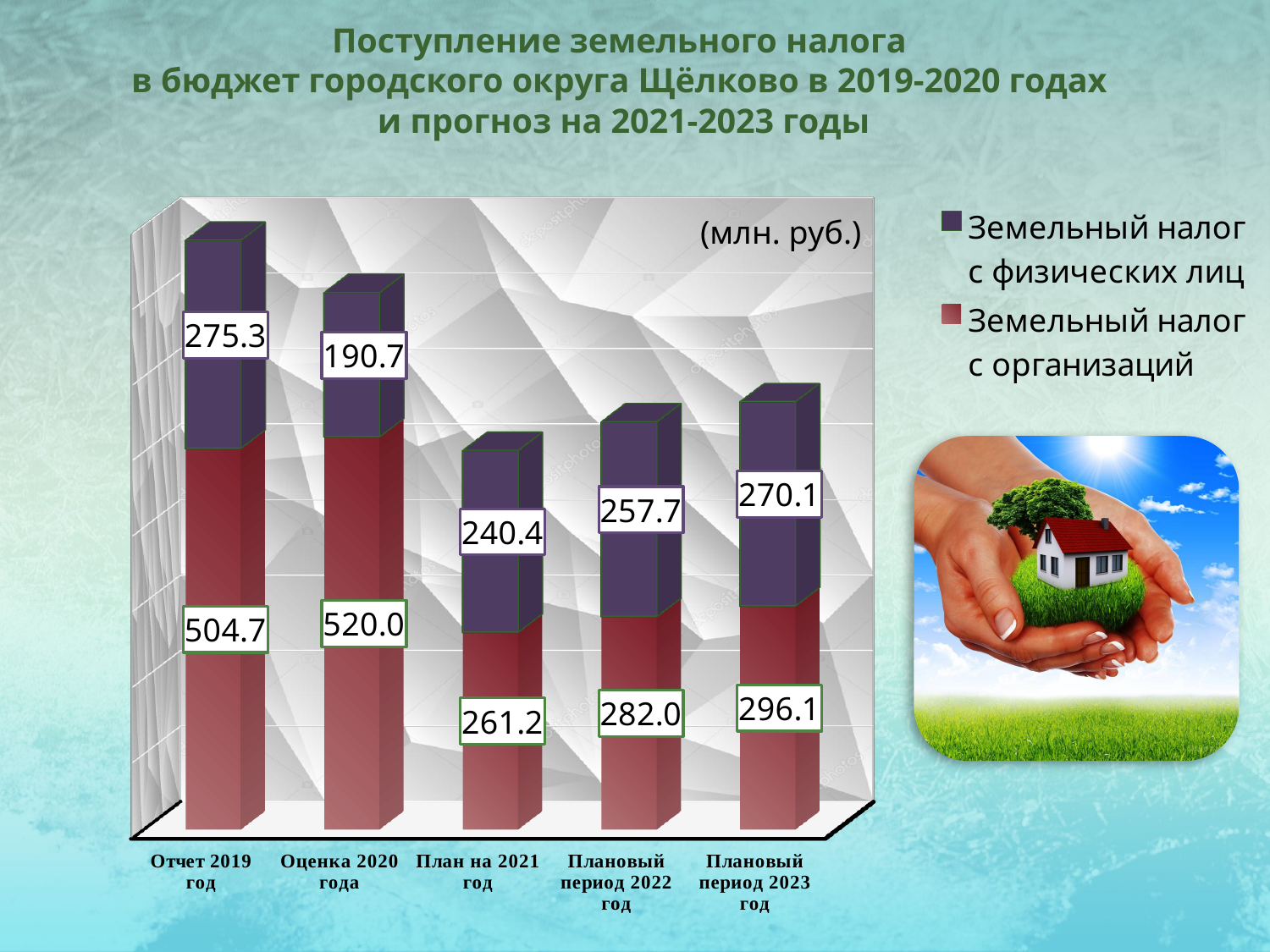
Which category has the lowest value for 'Земельный налог с физических лиц'? Оценка 2020 года How many series does the legend list? 2 What is the value of 'Земельный налог с физических лиц' for 'Плановый период 2023 год'? 270.1 What is the total of the stacked bar for 'План на 2021 год'? 501.6 What is the total of the stacked bar for 'Отчет 2019 год'? 780.0 What kind of chart is shown on the slide? Stacked bar chart Which category has the highest value for 'Земельный налог с организаций'? Оценка 2020 года What is the difference between 'Земельный налог с организаций' for 'Плановый период 2023 год' and 'План на 2021 год'? 34.9 What is the value of 'Земельный налог с организаций' for 'Оценка 2020 года'? 520.0 How many categories are shown on the x axis? 5 Which is larger: 'Земельный налог с физических лиц' for 'Отчет 2019 год' or for 'Плановый период 2022 год'? Отчет 2019 год What is the value of 'Земельный налог с физических лиц' for 'Отчет 2019 год'? 275.3